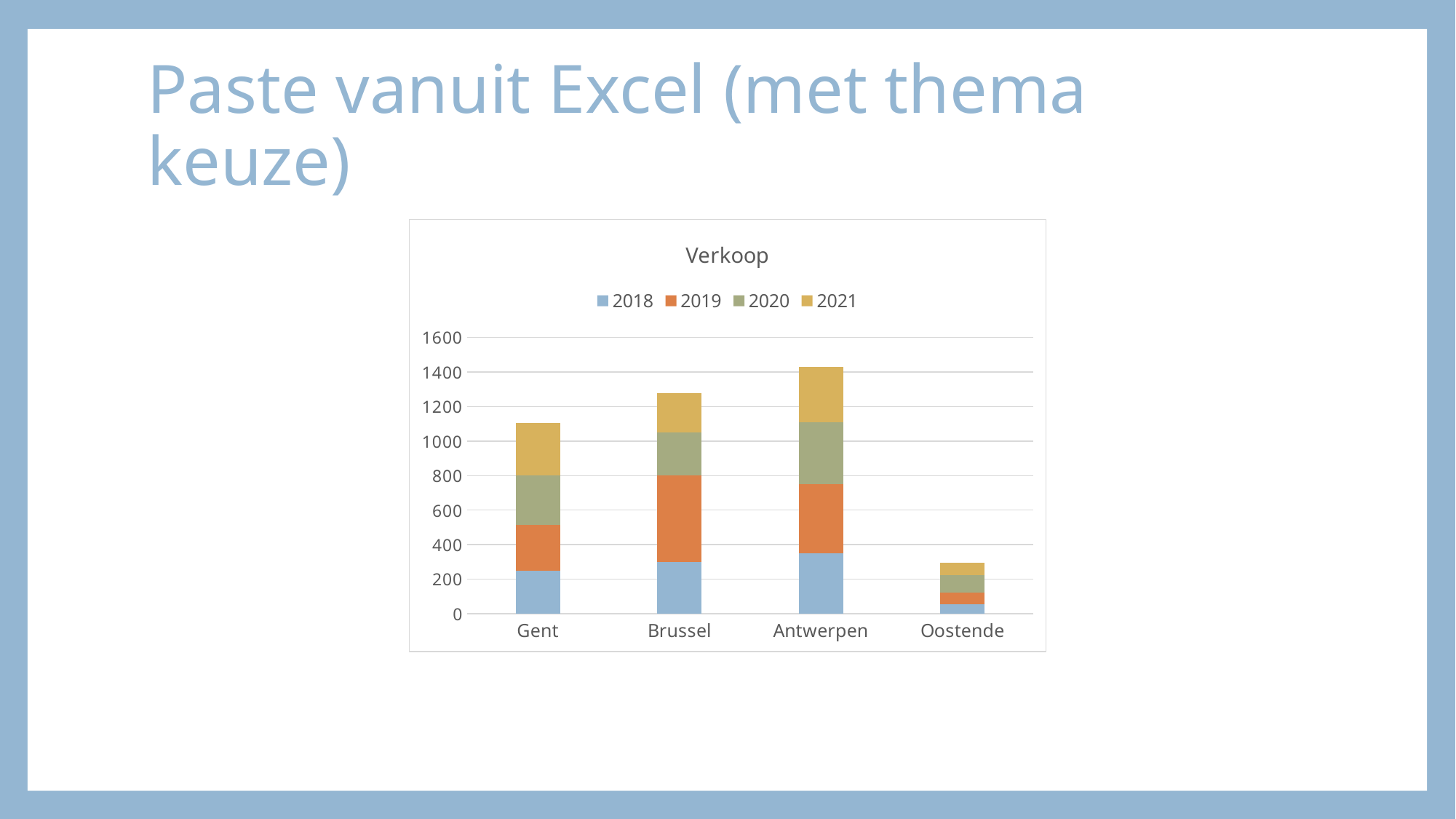
Which series is shown in the legend first, at the bottom of each stacked bar? 2018 What kind of chart is shown on the slide? Stacked bar chart How many series does the legend list? 4 Is the total stacked value for Gent greater or less than 1000? greater Which category has the highest total stacked bar? Antwerpen Which category has the lowest total stacked bar? Oostende How many categories are shown on the x axis? 4 What is the title of the chart? Verkoop Is the total stacked value for Antwerpen greater or less than 1200? greater Is the total stacked value for Oostende greater or less than 400? less Which has a larger total bar, Antwerpen or Gent? Antwerpen Which has a larger total bar, Brussel or Oostende? Brussel